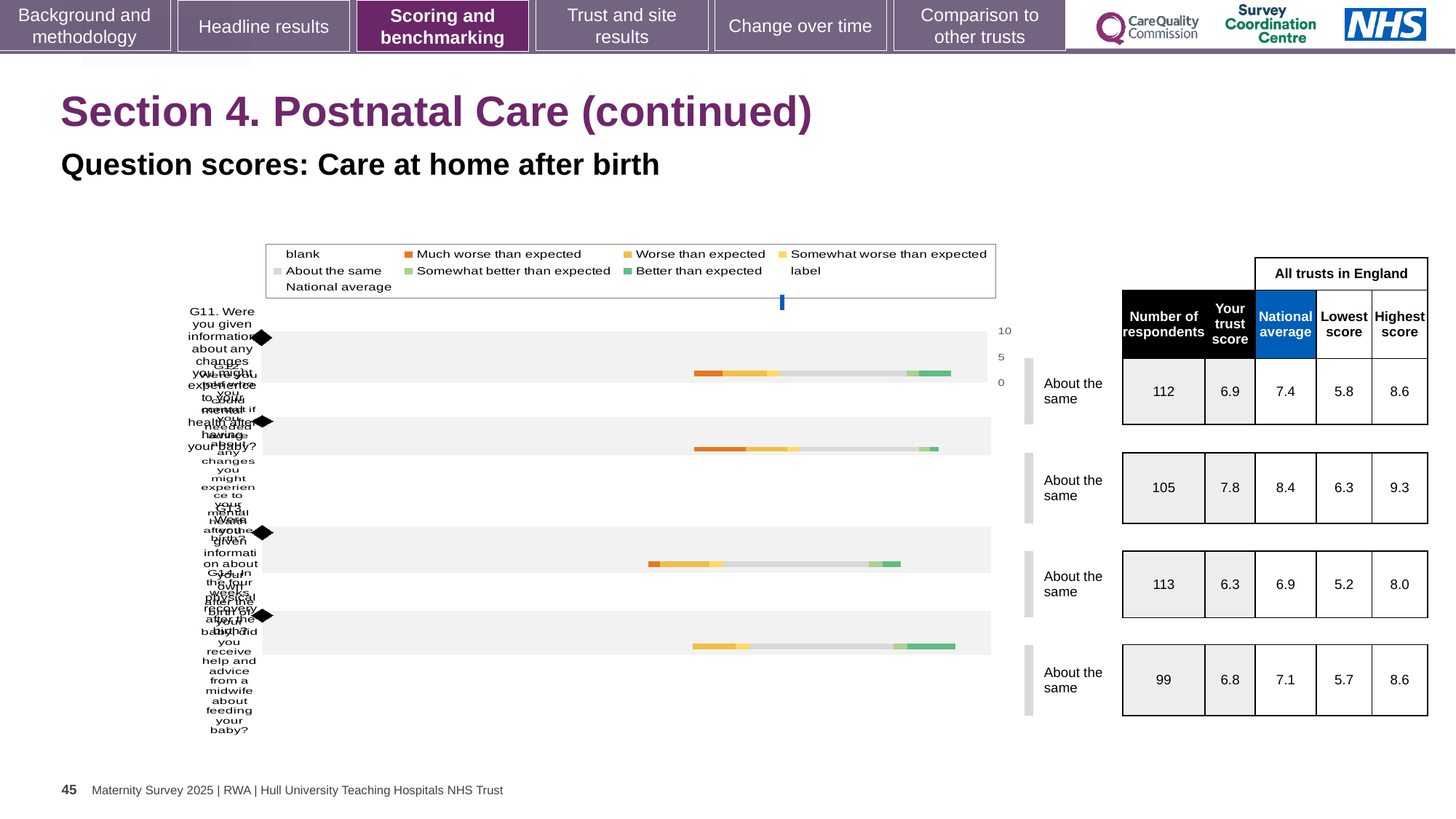
In the table beside the chart, what is the Number of respondents for the third question row? 113 Which question row has the lowest 'Your trust score' in the table beside the chart? the third row (6.3) In the table beside the chart, what is the 'Your trust score' for the first (top) question row? 6.9 How many question rows (bars) are plotted in the chart? 4 In the table beside the chart, what is the Highest score for the fourth (bottom) question row? 8.6 In the table beside the chart, what is the National average for the second question row? 8.4 Which question row has the highest 'Your trust score' in the table beside the chart? the second row (7.8) What kind of chart is shown on the slide? bar chart For the first question row, what is the difference between the National average and 'Your trust score'? 0.5 Which has the larger 'Your trust score': the second question row or the fourth question row? the second row What colour represents 'Much worse than expected' in the chart legend? orange What comparison category is shown next to each of the four question rows? About the same